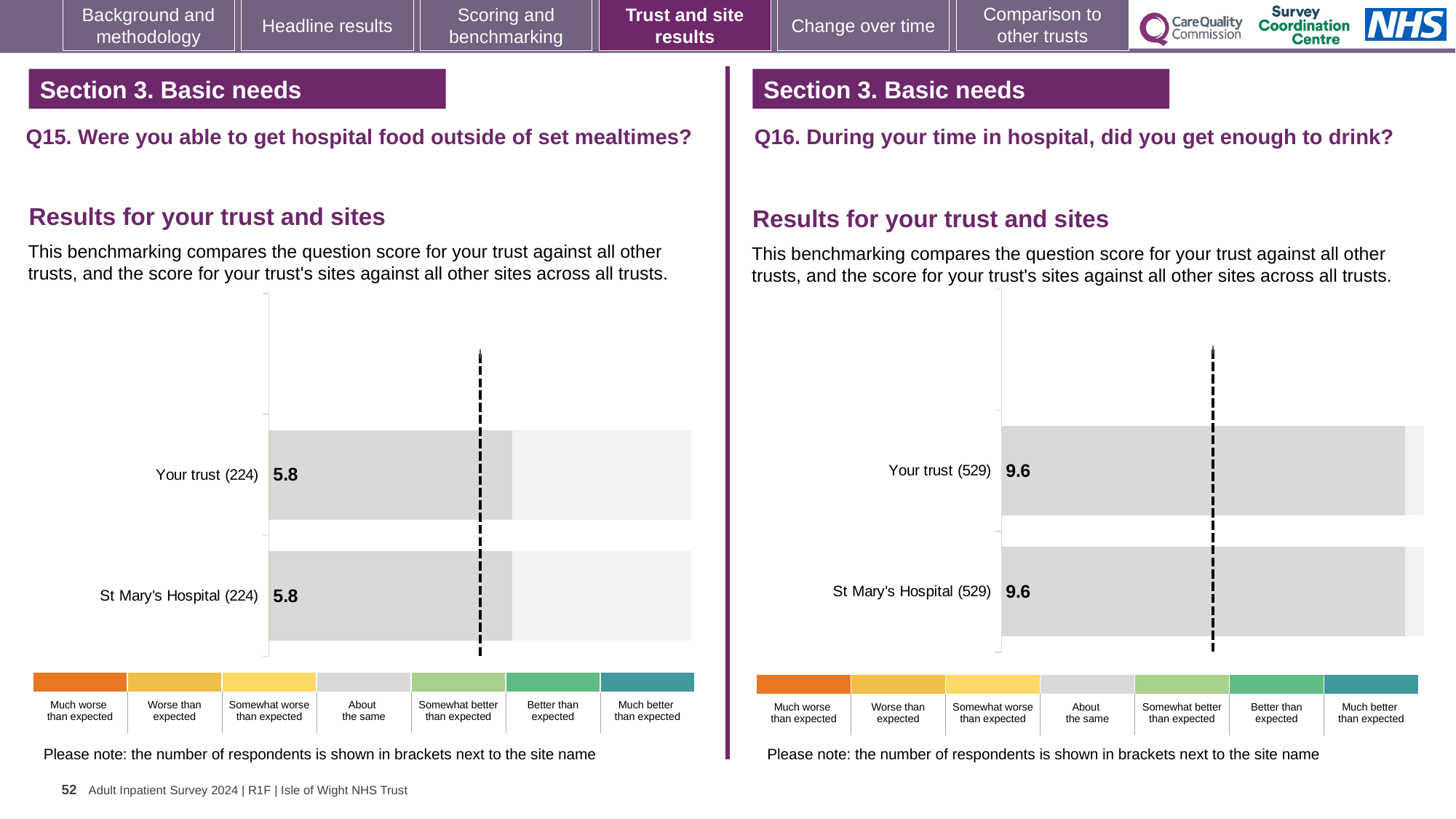
What kind of chart is used for the Q16 results on the right? Bar chart In the Q16 chart on the right, how many respondents are shown in brackets next to St Mary's Hospital? 529 In the Q16 chart on the right, what is the score for Your trust? 9.6 In the Q16 chart on the right, what is the difference between the score for Your trust and the score for St Mary's Hospital? 0 In the Q15 chart on the left, how many respondents are shown in brackets next to Your trust? 224 In the Q15 chart on the left, what is the difference between the score for Your trust and the score for St Mary's Hospital? 0 In the Q15 chart on the left, what is the score for Your trust? 5.8 In the Q16 chart on the right, what is the score for St Mary's Hospital? 9.6 How many bars are plotted in the Q15 chart on the left? 2 How many bars are plotted in the Q16 chart on the right? 2 How many categories does the colour key below the Q15 chart on the left list? 7 In the Q15 chart on the left, what is the score for St Mary's Hospital? 5.8